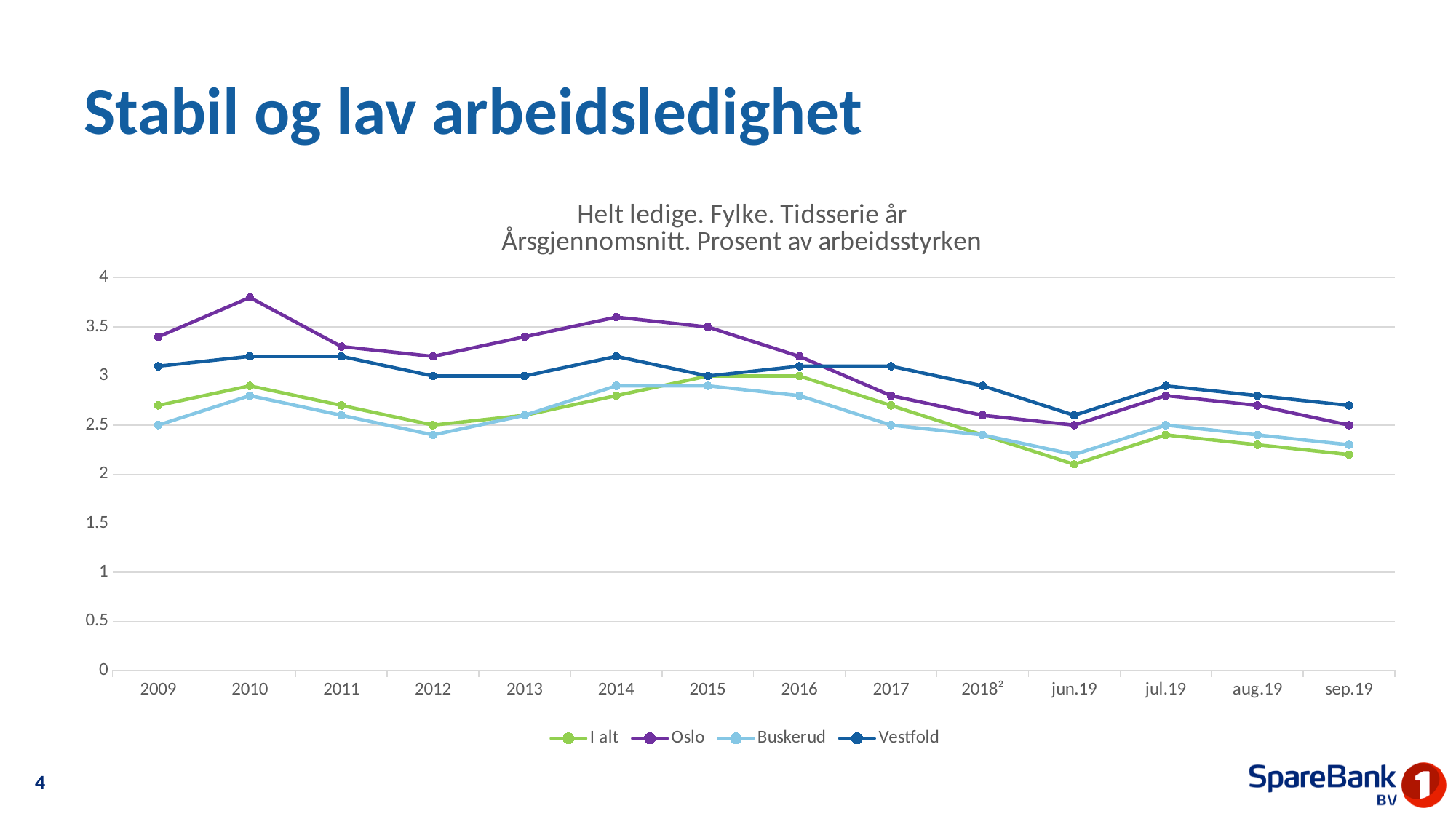
Is the value for Vestfold in 2014 greater or less than 3? greater Is the value for 'I alt' in jun.19 greater or less than 2.5? less In which year does the Oslo series reach its highest value? 2010 At which point on the x axis is the 'I alt' series at its lowest? jun.19 Which is larger in 2010, the value for Oslo or the value for 'I alt'? Oslo What kind of chart is shown on the slide? line chart Which is larger in 2017, the value for Vestfold or the value for Buskerud? Vestfold What is the title of the chart? Helt ledige. Fylke. Tidsserie år Årsgjennomsnitt. Prosent av arbeidsstyrken How many series does the legend list? 4 How many points are shown along the x axis? 14 Does the Oslo series rise or fall from 2016 to sep.19? fall Is the value for Oslo in 2010 greater or less than 3.5? greater